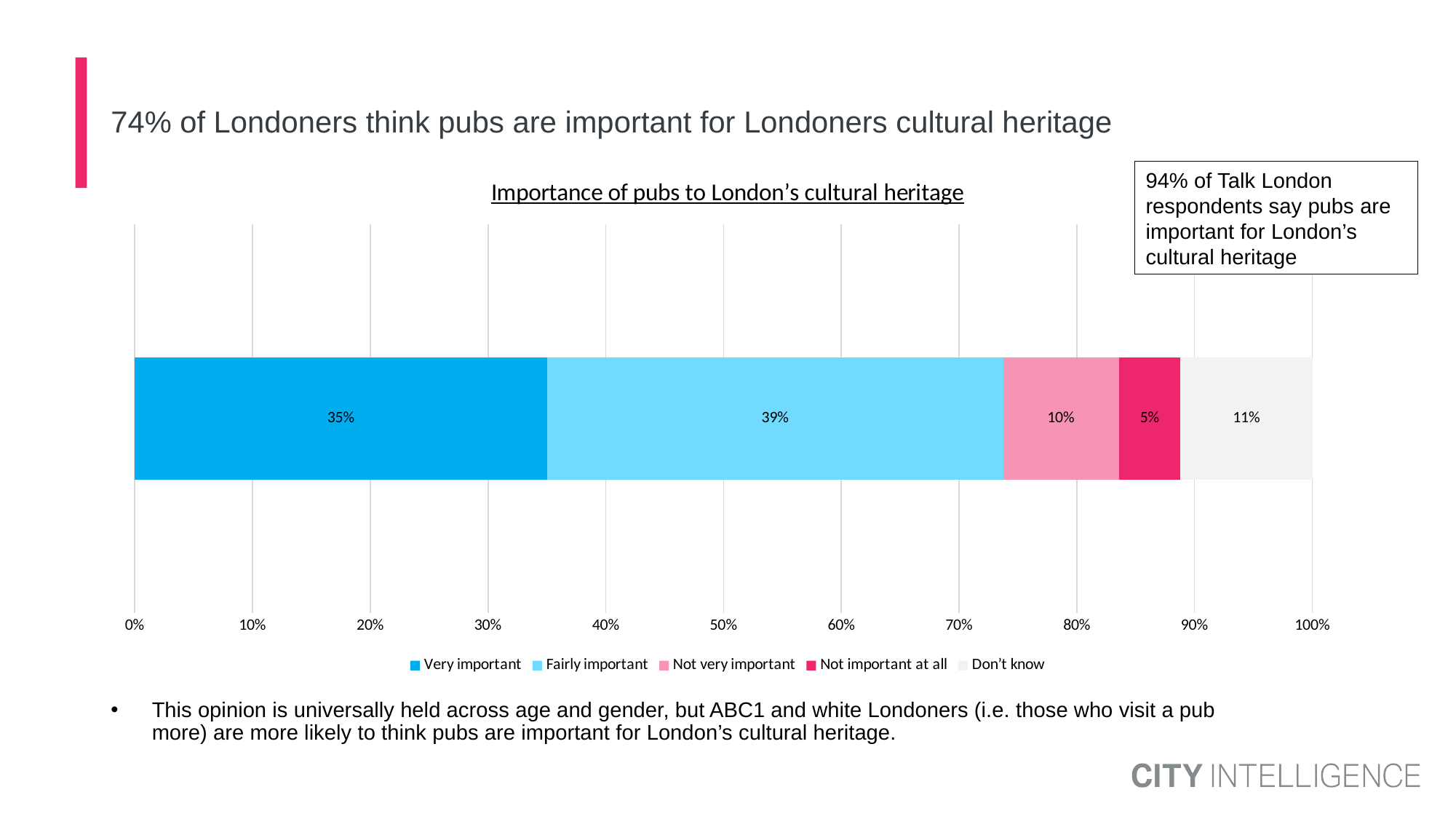
Which response category has the smallest share in the chart? Not important at all Which response category has the largest share in the chart? Fairly important How many response categories does the legend list? 5 What percentage of respondents said pubs are 'Fairly important'? 39% What is the difference in percentage points between 'Fairly important' and 'Very important'? 4 What percentage of respondents answered 'Not important at all'? 5% What percentage of respondents answered 'Not very important'? 10% Which is larger: the share for 'Don't know' or the share for 'Not very important'? Don't know What is the combined percentage of 'Very important' and 'Fairly important' responses? 74% What type of chart is shown on the slide? Stacked bar chart What percentage of respondents answered 'Don't know'? 11% What percentage of respondents said pubs are 'Very important' to London's cultural heritage? 35%